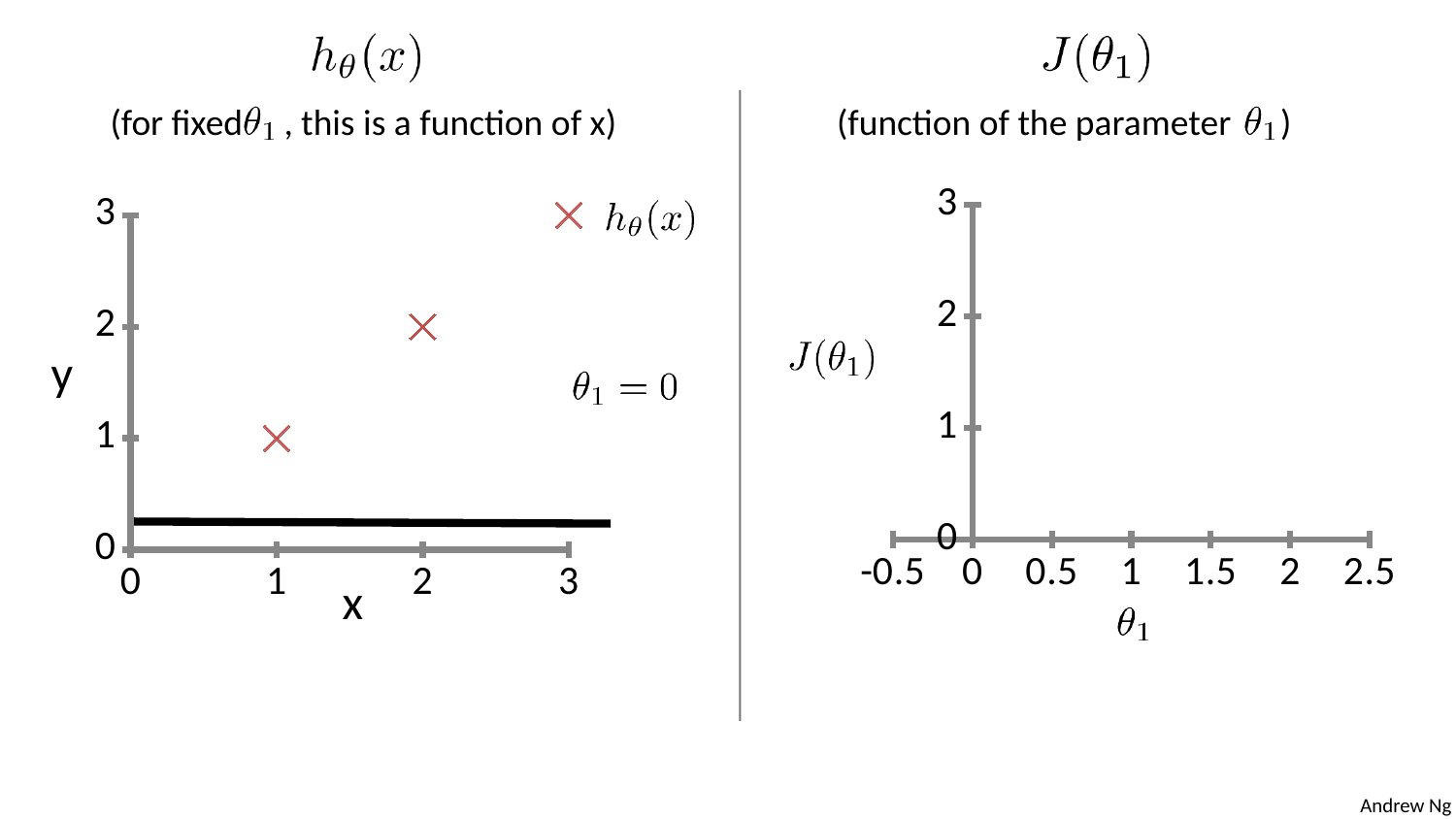
In the left chart titled hθ(x), which data point has the larger y value, the one at x = 1 or the one at x = 2? x = 2 What kind of chart is the left chart titled hθ(x)? scatter plot In the right chart titled J(θ1), what is the label of the horizontal axis? θ1 In the right chart titled J(θ1), what is the lowest tick value shown on the horizontal axis? -0.5 In the right chart titled J(θ1), what is the highest tick value shown on the horizontal axis? 2.5 In the left chart titled hθ(x), do the y values of the data points rise or fall as x increases? rise In the left chart titled hθ(x), what is the y value of the data point at x = 2? 2 In the left chart titled hθ(x), what is the difference between the y values of the points at x = 2 and x = 1? 1 In the left chart titled hθ(x), what is the y value of the data point at x = 1? 1 In the left chart titled hθ(x), is the value of the black line at x = 1 greater or less than 1? less In the right chart titled J(θ1), how many data points are plotted? 0 In the left chart titled hθ(x), what value of θ1 is written on the chart? θ1 = 0